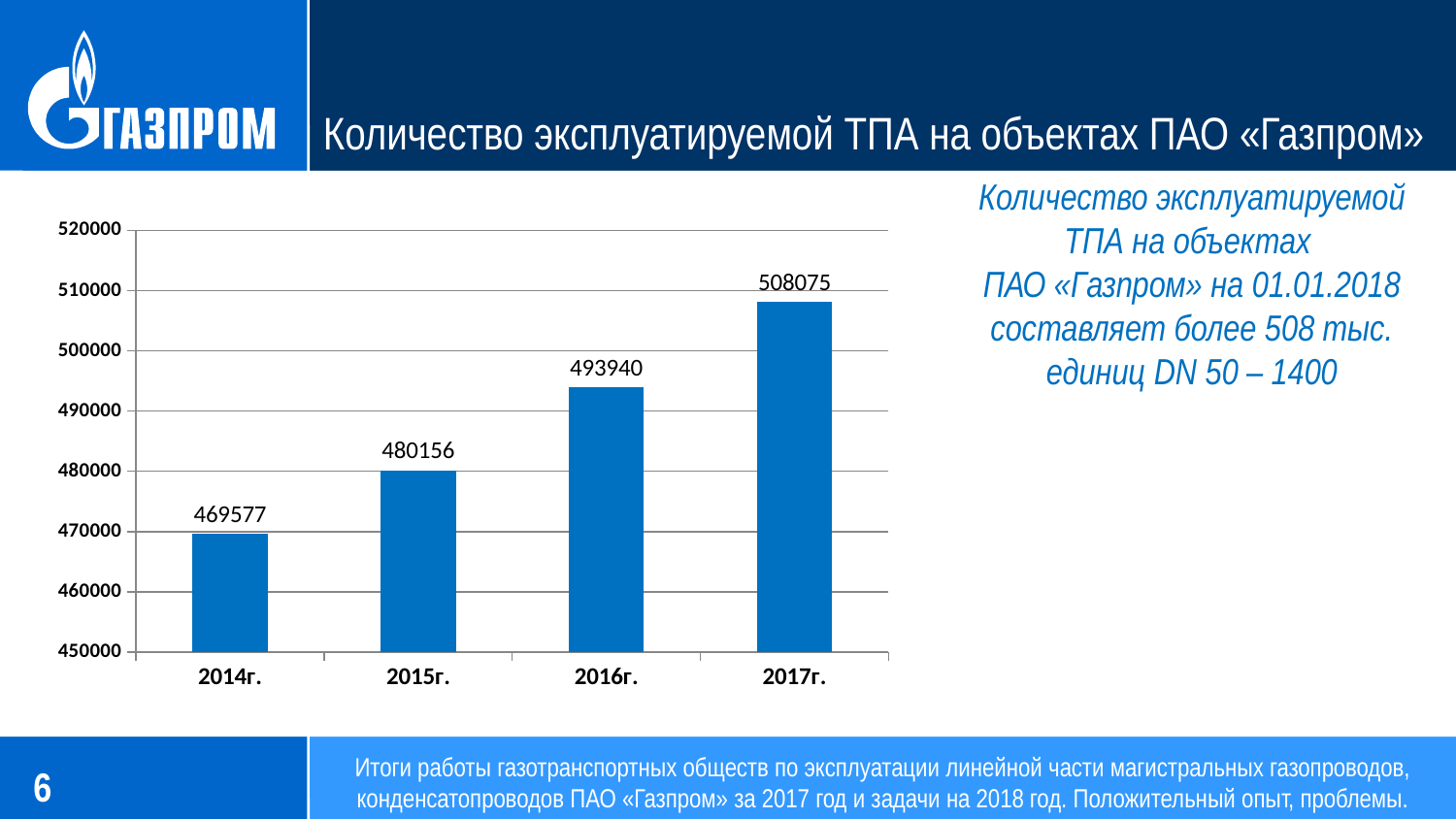
Which year has the lowest value? 2014г. What is the value for 2015г.? 480156 What kind of chart is shown on the slide? bar chart What is the value for 2017г.? 508075 What is the value for 2014г.? 469577 Which year has the highest value? 2017г. What is the difference between the values for 2016г. and 2015г.? 13784 Which is larger, the value for 2015г. or the value for 2016г.? 2016г. How many years are shown on the x axis? 4 What is the value for 2016г.? 493940 Do the values rise or fall from 2014г. to 2017г.? rise What is the difference between the values for 2017г. and 2014г.? 38498